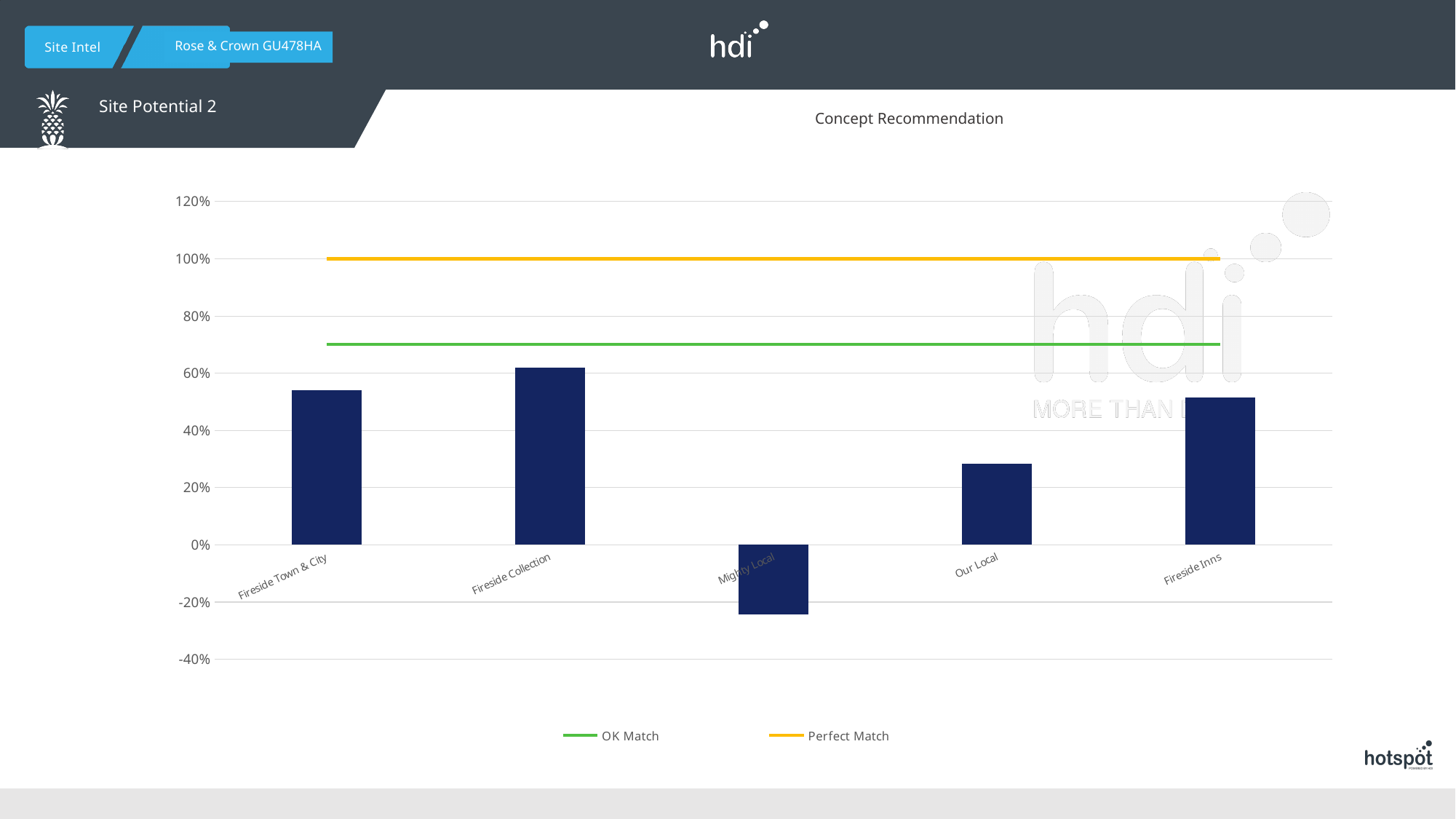
What kind of chart is shown on the slide? Combination bar and line chart Is the value for Mighty Local greater or less than 0%? less Is the value for Fireside Inns greater or less than 40%? greater How many entries does the legend list? 2 How many concept categories are plotted on the x axis? 5 Which concept has the lowest bar? Mighty Local Is the value for Our Local greater or less than 40%? less Which is larger, the value for Fireside Town & City or the value for Our Local? Fireside Town & City Which is larger, the value for Fireside Collection or the value for Fireside Inns? Fireside Collection What is the title shown above the chart? Concept Recommendation Which concept has the highest bar? Fireside Collection At what level is the Perfect Match line drawn? 100%